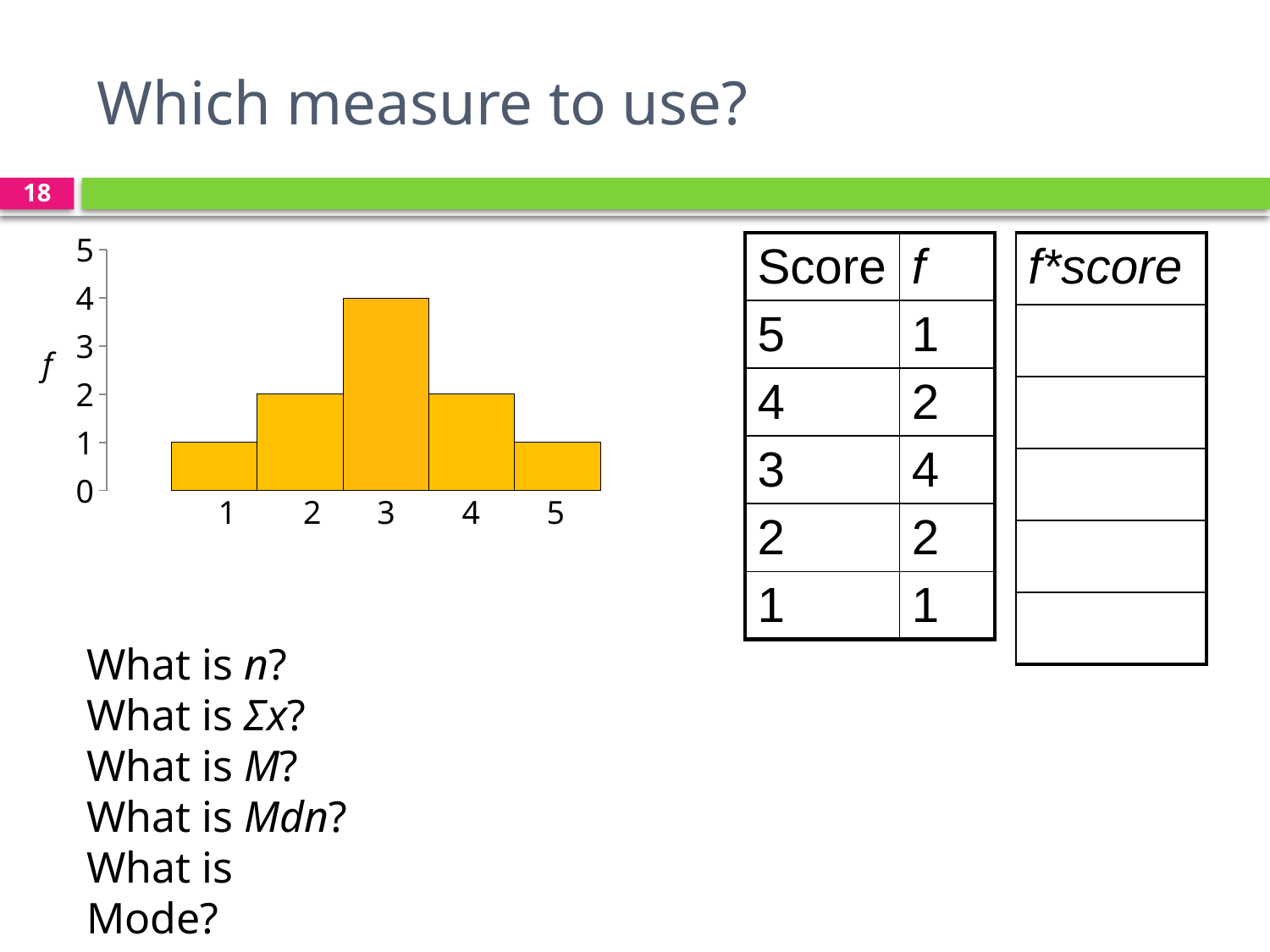
What is the label on the y axis of the chart? f What is the frequency (f) for score 3 in the chart? 4 What is the difference between the frequency for score 3 and the frequency for score 5? 3 Is the frequency for score 3 greater or less than 3? greater What is the frequency (f) for score 4 in the chart? 2 Which score has the highest frequency in the chart? 3 Which score has a higher frequency, 2 or 3? 3 What type of chart is shown on the slide? bar chart What is the highest value shown on the y axis of the chart? 5 Do the frequencies rise or fall from score 3 to score 5 along the x axis? fall What is the frequency (f) for score 1 in the chart? 1 How many bars are plotted in the chart? 5